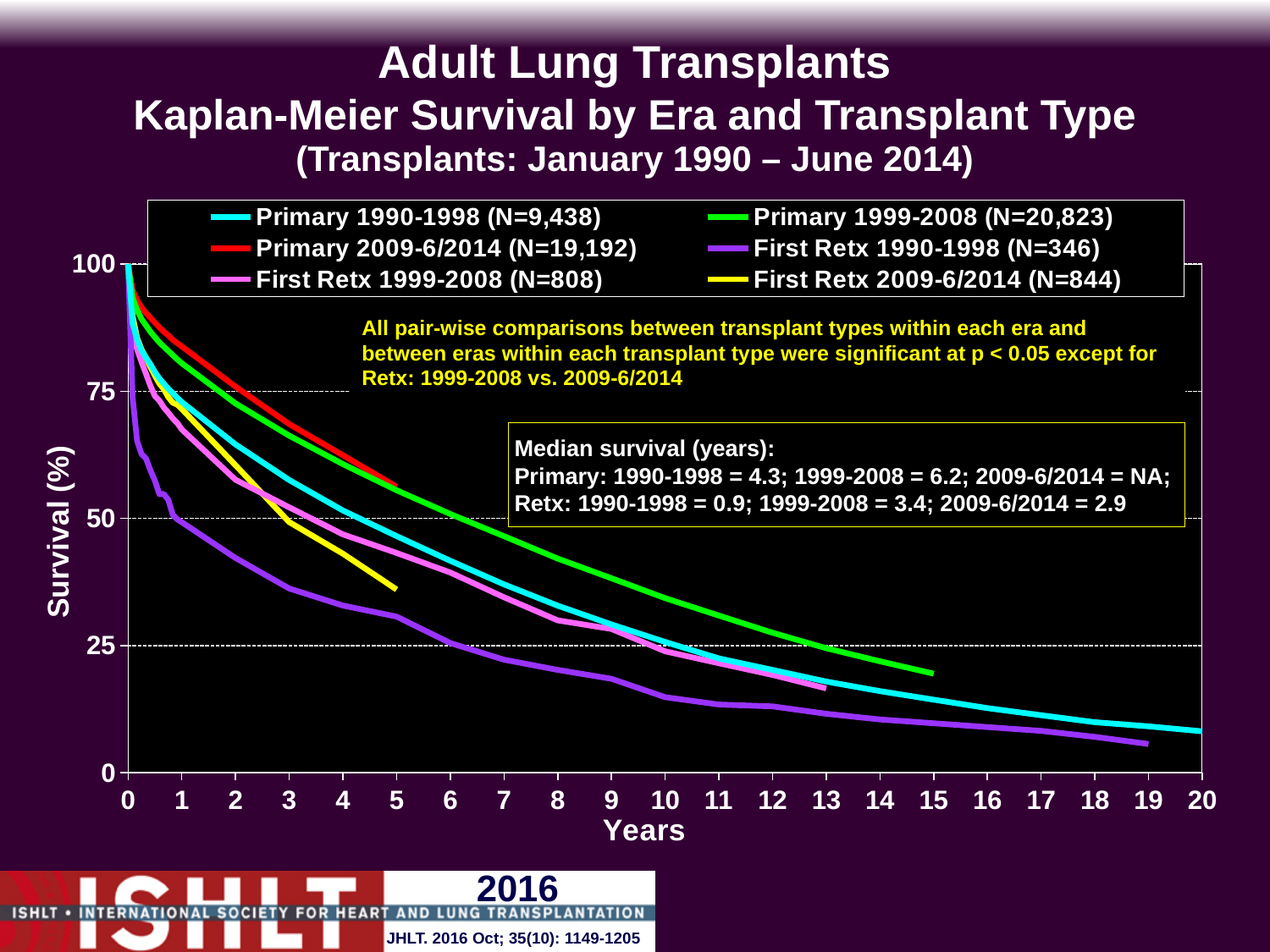
Is the survival for First Retx 1990-1998 at 5 years greater or less than 25? greater Is the survival for Primary 1999-2008 at 5 years greater or less than 50? greater What is the median survival in years for First Retx transplants in 1990-1998, as stated on the slide? 0.9 What is the median survival in years for First Retx transplants in 2009-6/2014, as stated on the slide? 2.9 What is the N for the Primary 1999-2008 series in the legend? 20,823 What kind of chart is shown on the slide? Line chart What is the median survival in years for Primary transplants in 1999-2008, as stated on the slide? 6.2 Which series has the lowest survival at 3 years? First Retx 1990-1998 How many series does the legend list? 6 Is the survival for Primary 1990-1998 at 5 years greater or less than 50? less Do the survival curves rise or fall as years increase? Fall Which series extends furthest along the x axis, reaching 20 years? Primary 1990-1998